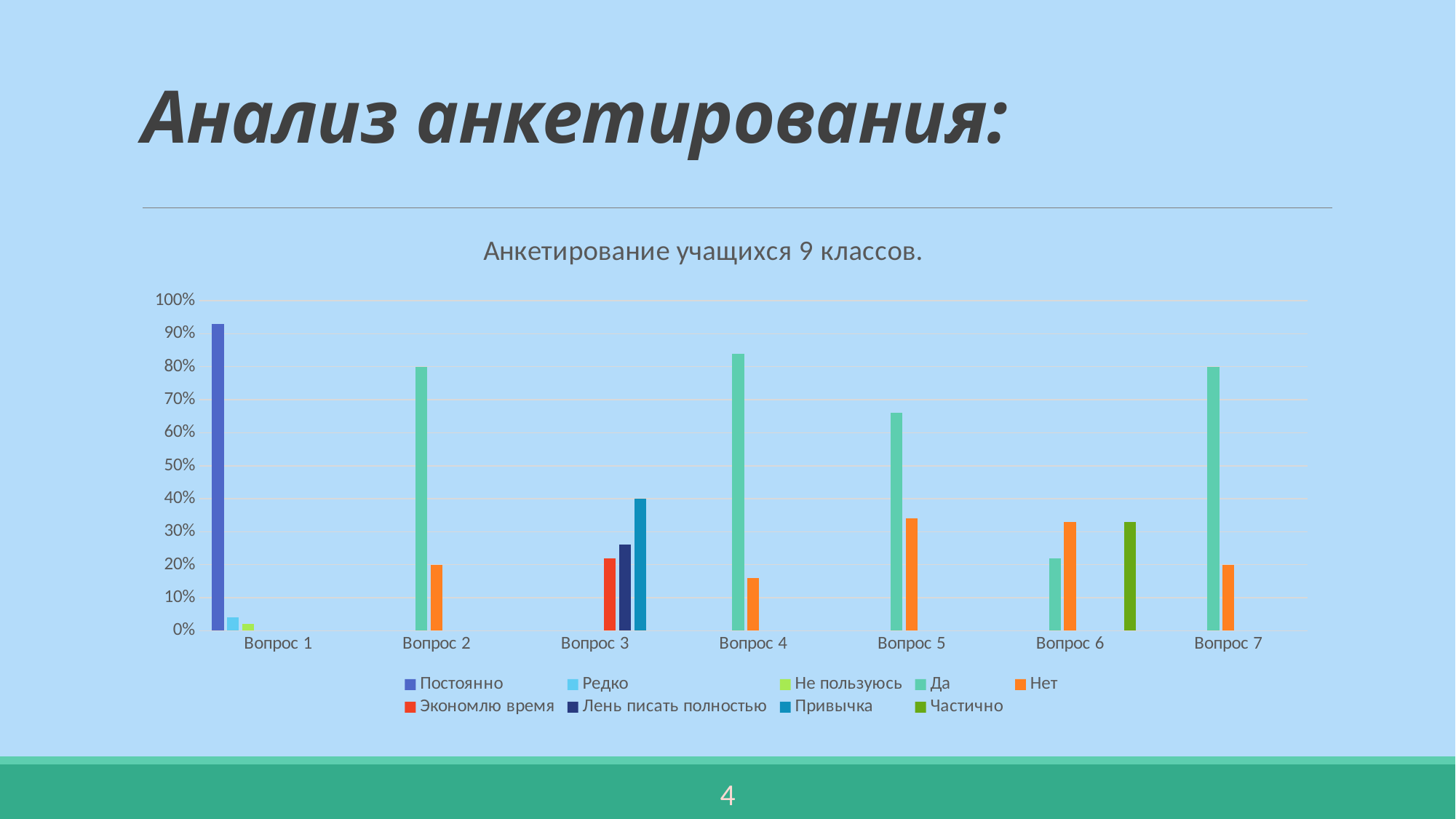
What kind of chart is shown on the slide? bar chart Which series has the lowest value in Вопрос 1? Не пользуюсь What is the value of "Привычка" for Вопрос 3? 40% What is the title of the chart? Анкетирование учащихся 9 классов. Is the value for "Нет" in Вопрос 4 greater or less than 20%? less Which series has the highest value in Вопрос 3? Привычка What is the value of "Да" for Вопрос 2? 80% How many categories (questions) are shown on the x axis? 7 What is the value of "Нет" for Вопрос 7? 20% In Вопрос 5, which is larger: "Да" or "Нет"? Да Is the value for "Постоянно" in Вопрос 1 greater or less than 90%? greater How many series does the legend list? 9